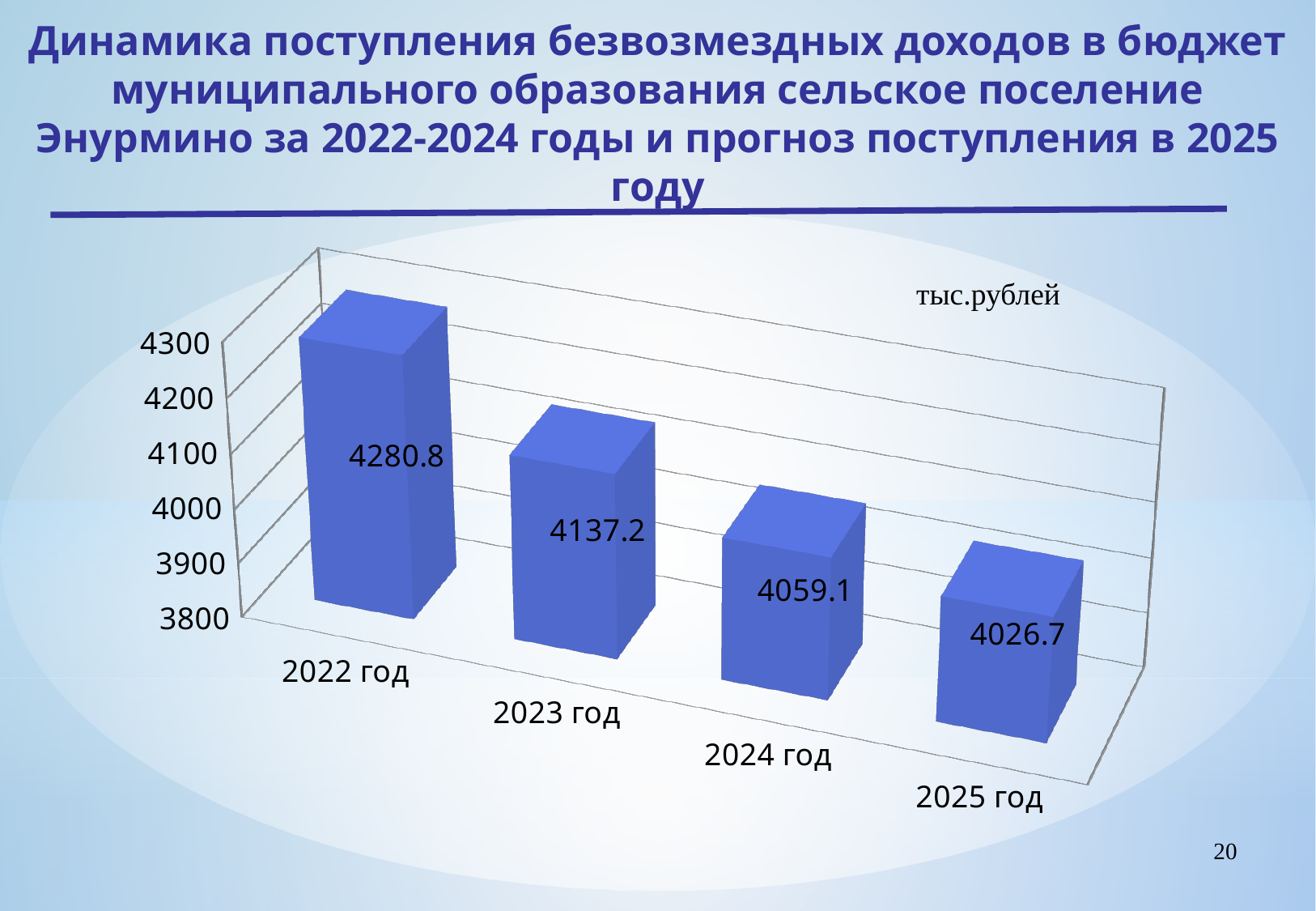
Which year has the highest value? 2022 год What is the difference between the values for 2022 год and 2025 год? 254.1 What is the value for 2022 год? 4280.8 What is the value for 2023 год? 4137.2 What is the value for 2025 год? 4026.7 Which is larger, the value for 2023 год or the value for 2024 год? 2023 год What kind of chart is shown on the slide? Bar chart Which year has the lowest value? 2025 год What is the value for 2024 год? 4059.1 Do the values rise or fall from 2022 год to 2025 год? Fall How many years are shown on the chart? 4 What is the difference between the values for 2022 год and 2023 год? 143.6